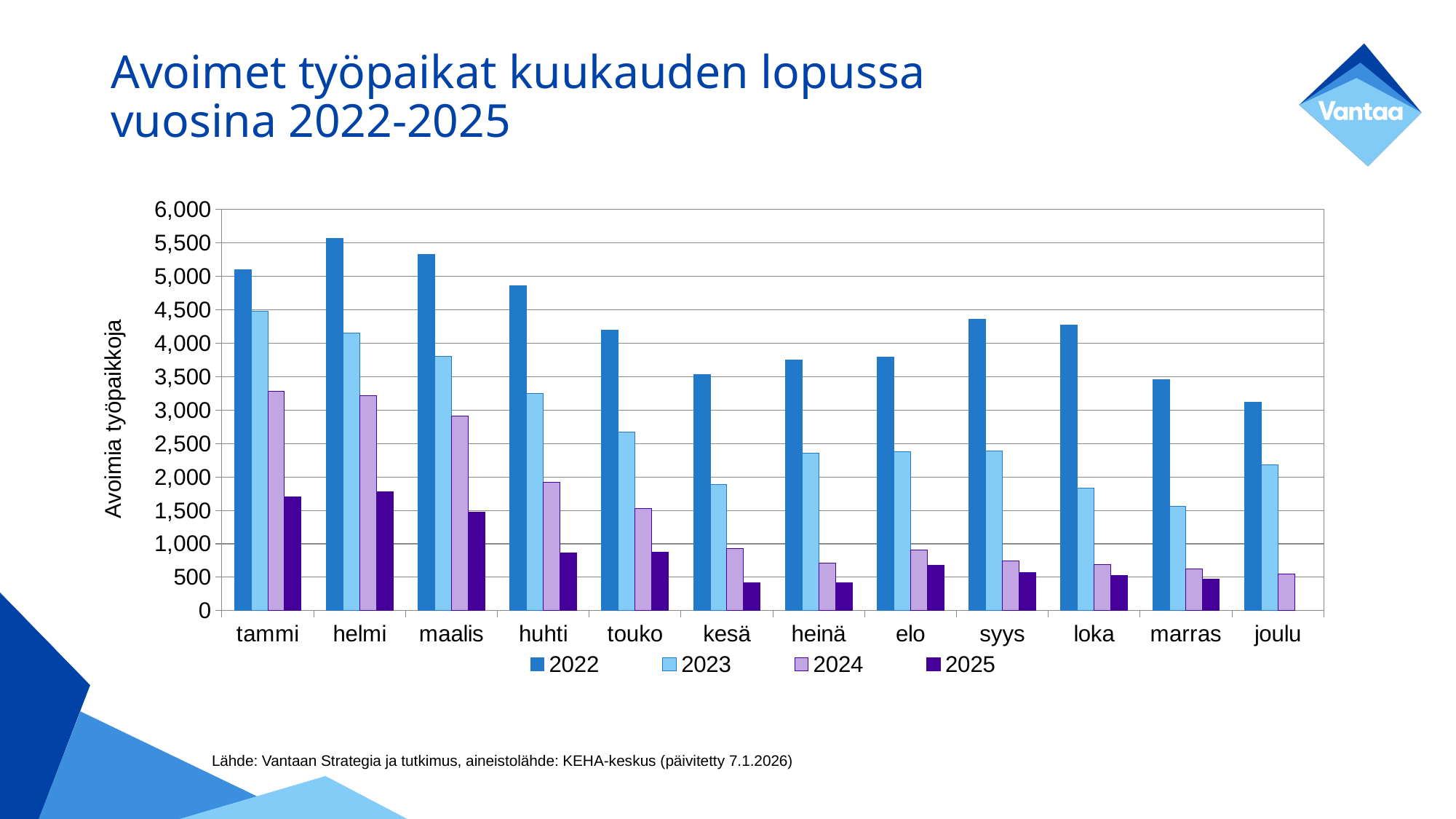
Do the 2024 values generally rise or fall from tammi to joulu? fall In which month is the 2023 value lowest? marras What kind of chart is shown on the slide? bar chart In which month is the 2022 value highest? helmi Is the 2023 value for kesä greater or less than 2,000? less How many series does the legend list? 4 What is the title of the vertical axis? Avoimia työpaikkoja In which month is the 2022 value lowest? joulu In which month is the 2023 value highest? tammi Is the 2022 value for tammi greater or less than 5,000? greater Which is larger, the 2022 value for helmi or the 2022 value for maalis? helmi How many months are shown on the x axis? 12